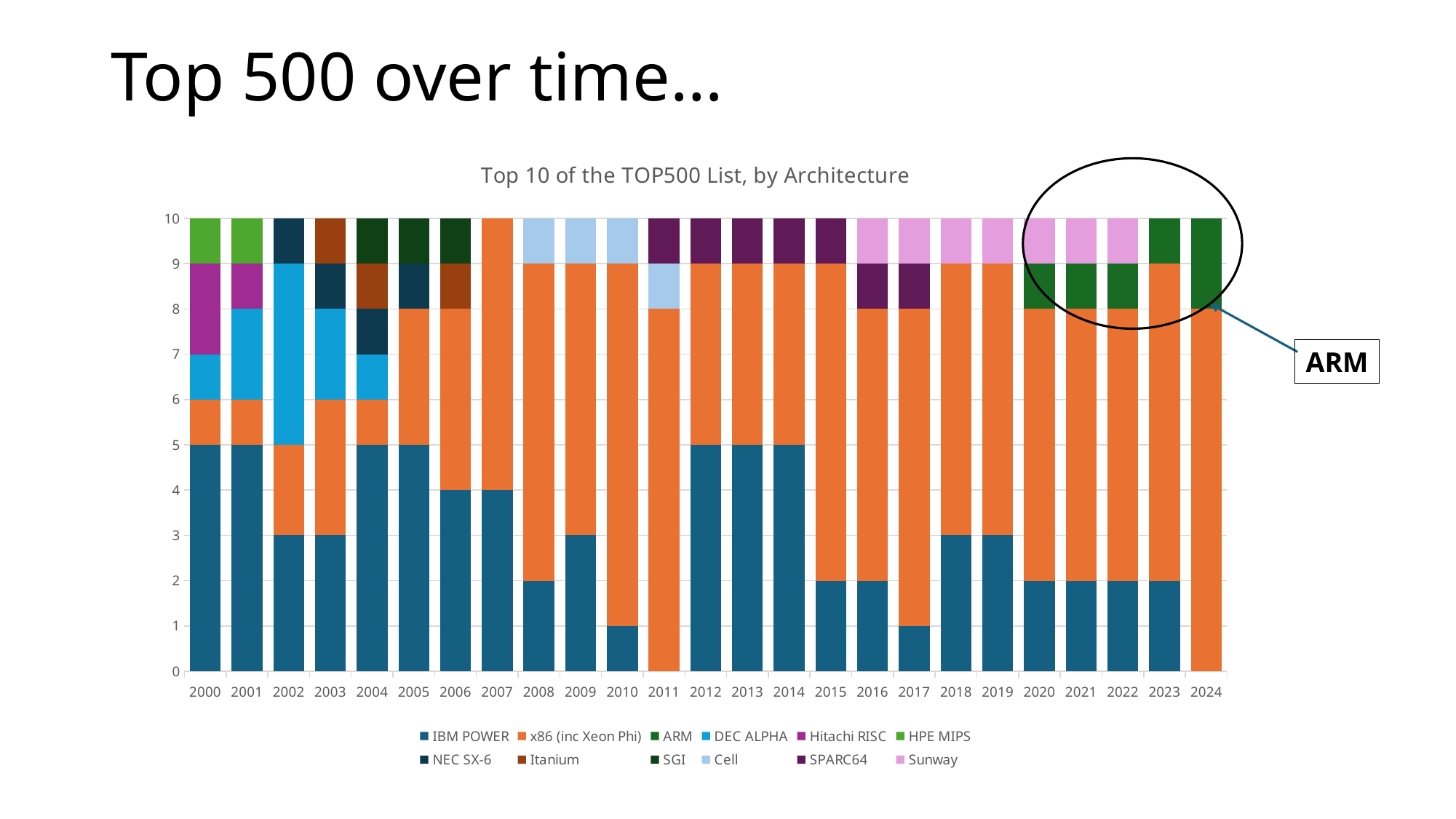
Does the IBM POWER count rise or fall from 2014 to 2017? Fall What kind of chart is shown on the slide? Stacked bar chart What is the difference between the IBM POWER count in 2000 and in 2010? 4 How many years are shown along the x axis of the chart? 25 How many of the top 10 systems used DEC ALPHA in 2002? 4 Which year has the larger x86 (inc Xeon Phi) segment, 2007 or 2008? 2008 What is the title of the chart? Top 10 of the TOP500 List, by Architecture How many architectures does the chart's legend list? 12 How many of the top 10 systems used IBM POWER in 2000? 5 How many of the top 10 systems used ARM in 2020? 1 How many of the top 10 systems used x86 (inc Xeon Phi) in 2024? 8 What is the total height of the stacked bar for 2012? 10